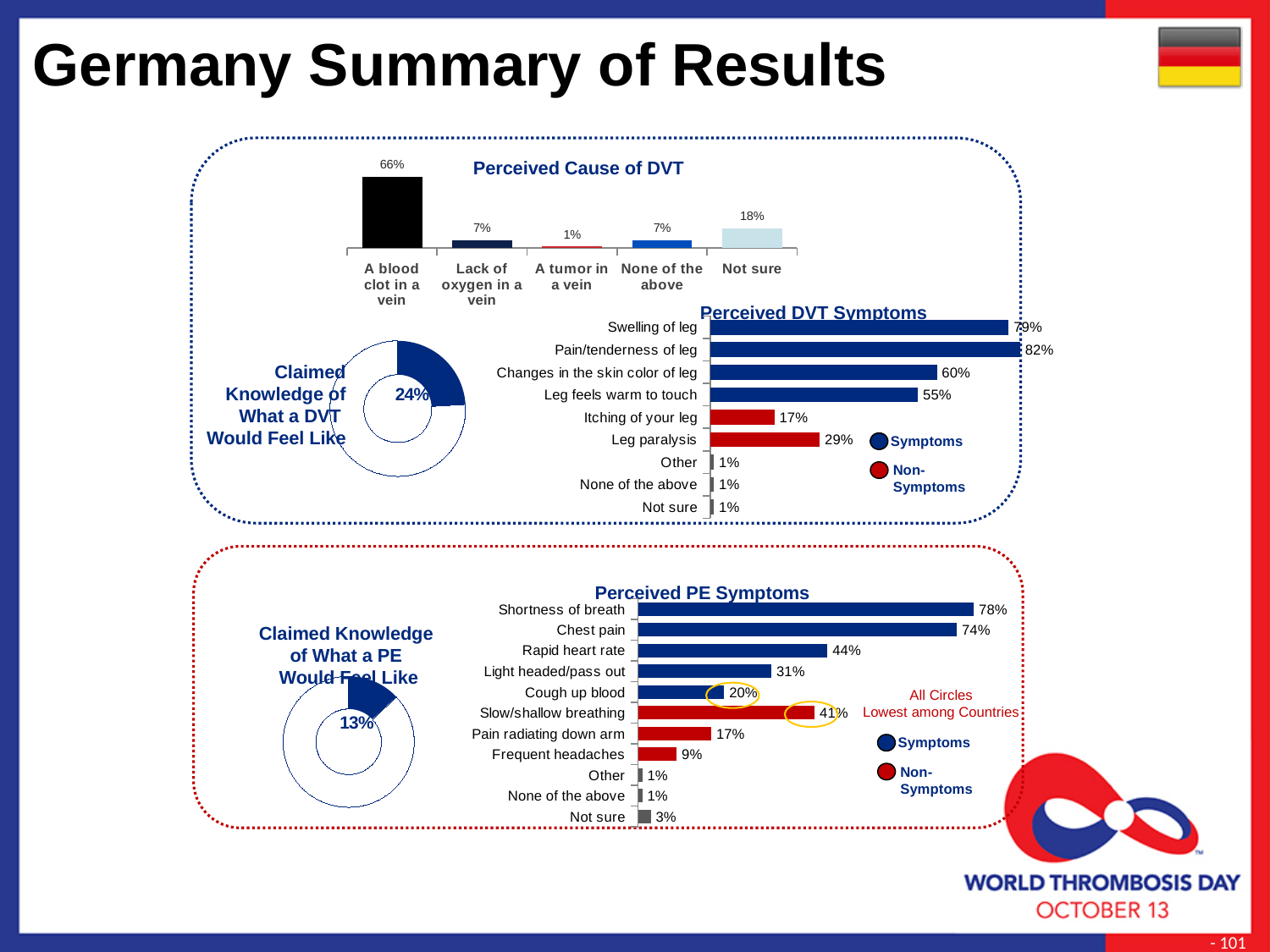
What type of chart is the Perceived PE Symptoms chart? Bar chart In the Perceived DVT Symptoms chart, which symptom has the highest value? Pain/tenderness of leg In the Perceived PE Symptoms chart, what is the difference between 'Shortness of breath' and 'Chest pain'? 4% In the Perceived DVT Symptoms chart, which is larger: 'Leg paralysis' or 'Itching of your leg'? Leg paralysis In the Perceived Cause of DVT chart, what is the difference between 'Not sure' and 'Lack of oxygen in a vein'? 11% In the Perceived Cause of DVT chart, which category has the lowest value? A tumor in a vein In the Perceived PE Symptoms chart, what percentage is shown for 'Slow/shallow breathing'? 41% What value is shown in the Claimed Knowledge of What a PE Would Feel Like donut chart? 13% In the Perceived Cause of DVT chart, what percentage is shown for 'A blood clot in a vein'? 66% In the Perceived Cause of DVT chart, how many categories are shown? 5 What value is shown in the Claimed Knowledge of What a DVT Would Feel Like donut chart? 24% In the Perceived DVT Symptoms chart, what percentage is shown for 'Pain/tenderness of leg'? 82%